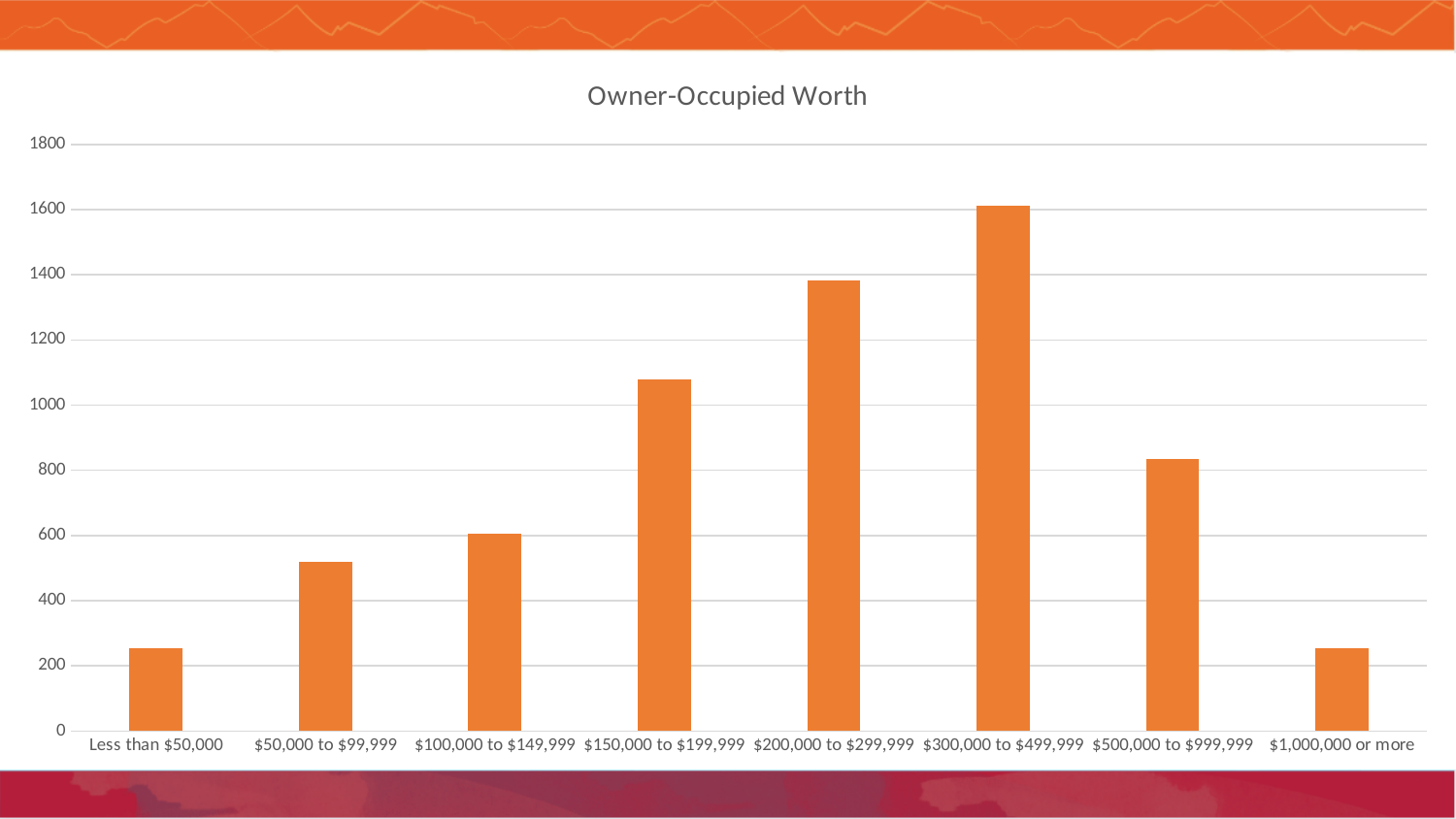
Is the value for $200,000 to $299,999 greater or less than 1400? less What is the title of the chart? Owner-Occupied Worth Is the value for $500,000 to $999,999 greater or less than 800? greater Which is larger, the value for $100,000 to $149,999 or the value for $500,000 to $999,999? $500,000 to $999,999 What type of chart is shown on the slide? bar chart How many categories are shown on the x axis? 8 Is the value for $1,000,000 or more greater or less than 400? less Do the values rise or fall from Less than $50,000 to $300,000 to $499,999? rise Which category has the highest value? $300,000 to $499,999